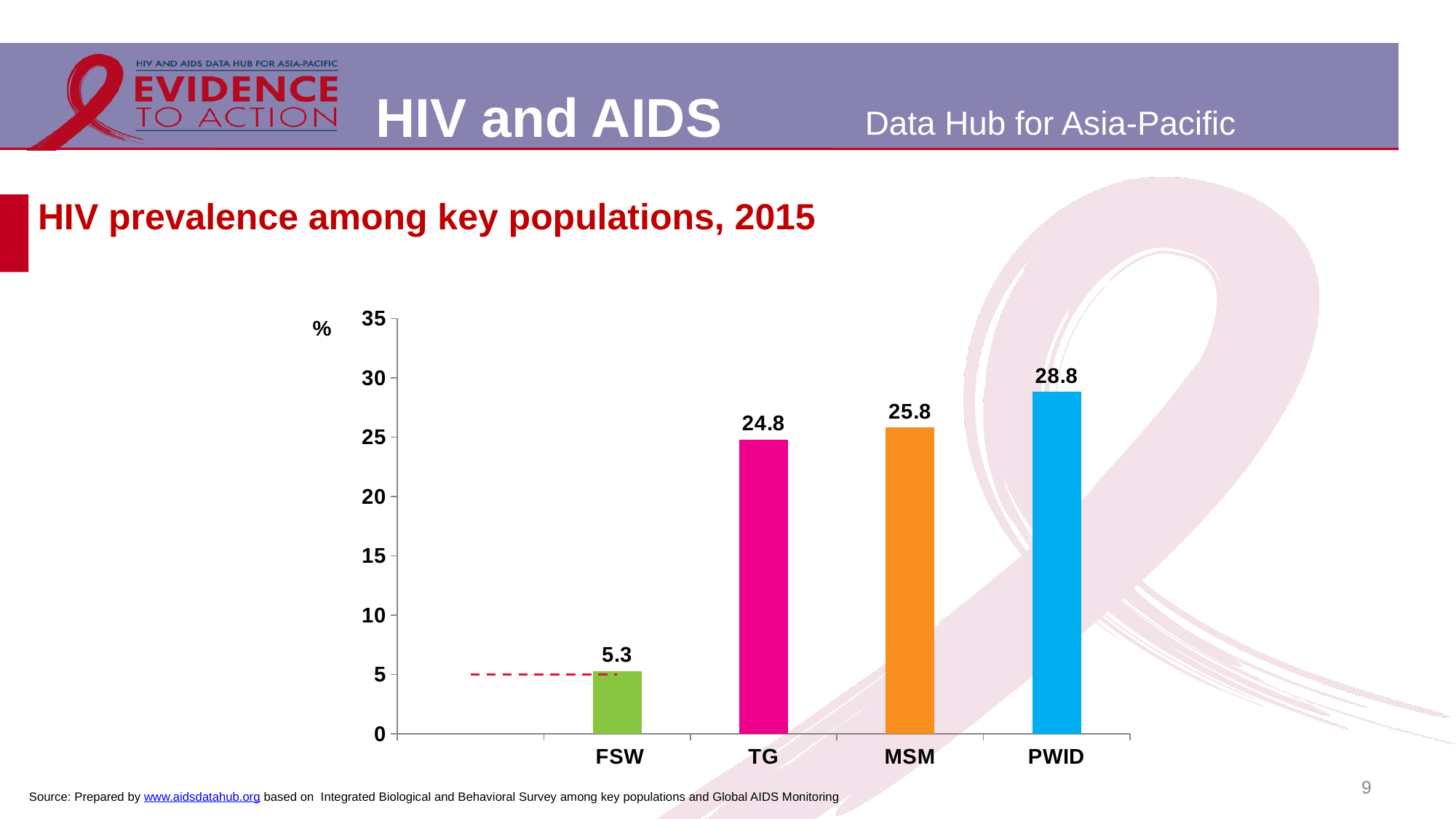
What is the HIV prevalence value shown for PWID? 28.8 What is the HIV prevalence value shown for TG? 24.8 What kind of chart is shown on the slide? Bar chart Which key population has the lowest HIV prevalence on the chart? FSW What is the title of the chart on the slide? HIV prevalence among key populations, 2015 Which key population has the highest HIV prevalence on the chart? PWID How many key populations are shown on the chart? 4 What is the difference between the HIV prevalence for MSM and for TG? 1.0 What is the difference between the HIV prevalence for PWID and for FSW? 23.5 Which has a higher HIV prevalence, TG or PWID? PWID What is the HIV prevalence value shown for MSM? 25.8 What is the HIV prevalence value shown for FSW? 5.3